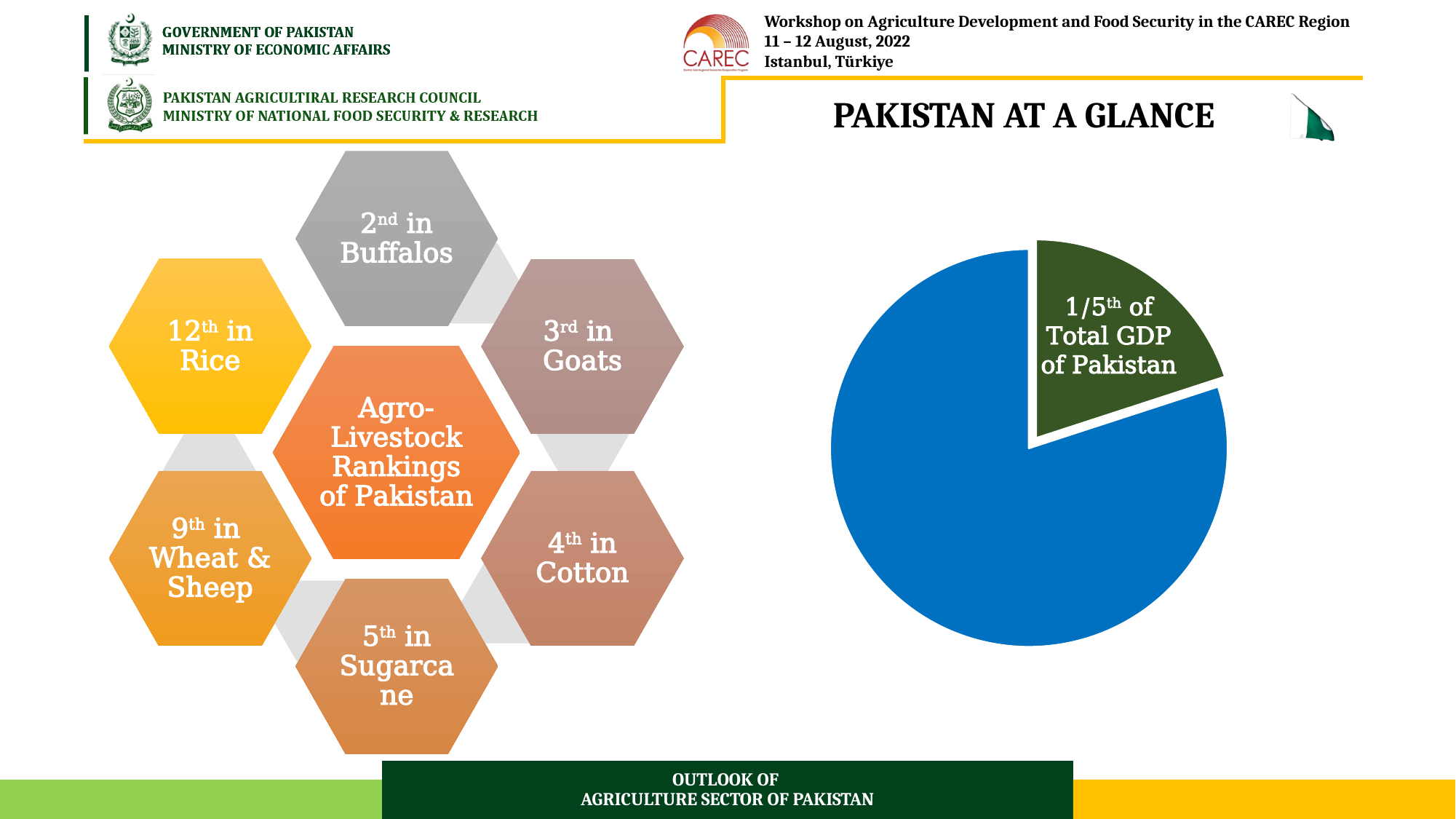
What colour is the slice of the pie chart labelled "1/5th of Total GDP of Pakistan"? green What kind of chart is shown on the right side of the slide? pie chart According to the label on the pie chart, what share of Pakistan's total GDP does the green slice represent? 1/5th How many slices does the pie chart have? 2 Which slice of the pie chart is the smallest? the green slice (1/5th of Total GDP of Pakistan) What is the title of the slide containing the pie chart? PAKISTAN AT A GLANCE Which slice of the pie chart is the largest? the blue slice Which slice of the pie chart is larger, the blue slice or the green slice? the blue slice What text is printed on the green slice of the pie chart? 1/5th of Total GDP of Pakistan